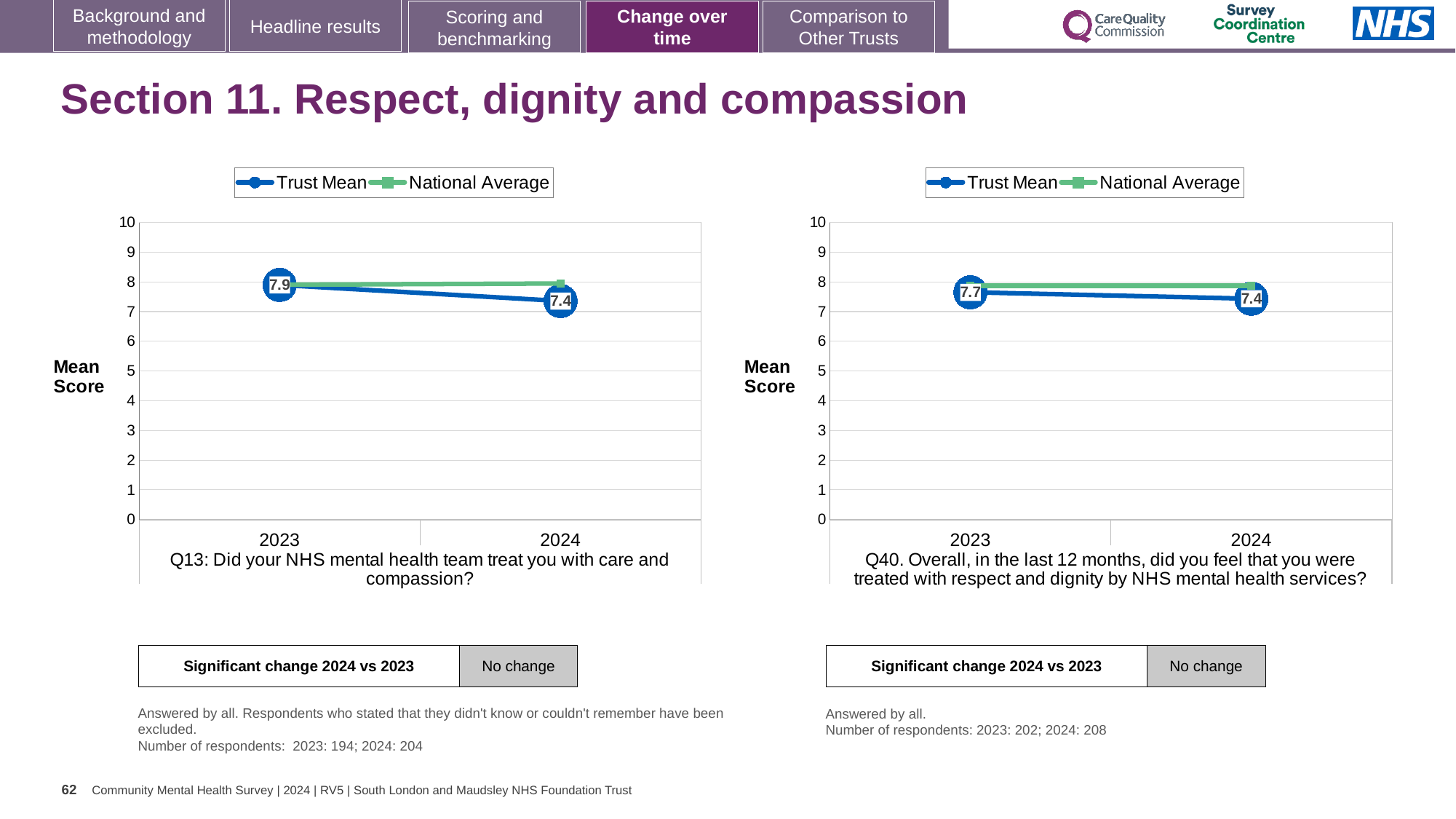
In the Q13 chart on the left, what is the Trust Mean for 2023? 7.9 Which is larger: the 2023 Trust Mean in the Q13 chart on the left or the 2023 Trust Mean in the Q40 chart on the right? Q13 chart (7.9) How many series does the legend of the Q13 chart on the left list? 2 In the Q40 chart on the right, what is the Trust Mean for 2023? 7.7 In the Q13 chart on the left, is the National Average for 2024 greater or less than 7? greater In the Q13 chart on the left, by how much did the Trust Mean fall from 2023 to 2024? 0.5 In the Q40 chart on the right, what is the Trust Mean for 2024? 7.4 In the Q40 chart on the right, what is the difference between the Trust Mean in 2023 and 2024? 0.3 In the Q13 chart on the left, what is the Trust Mean for 2024? 7.4 How many years are shown on the x axis of the Q40 chart on the right? 2 What kind of chart is the Q40 chart on the right? line chart In the Q13 chart on the left, does the Trust Mean rise or fall from 2023 to 2024? fall